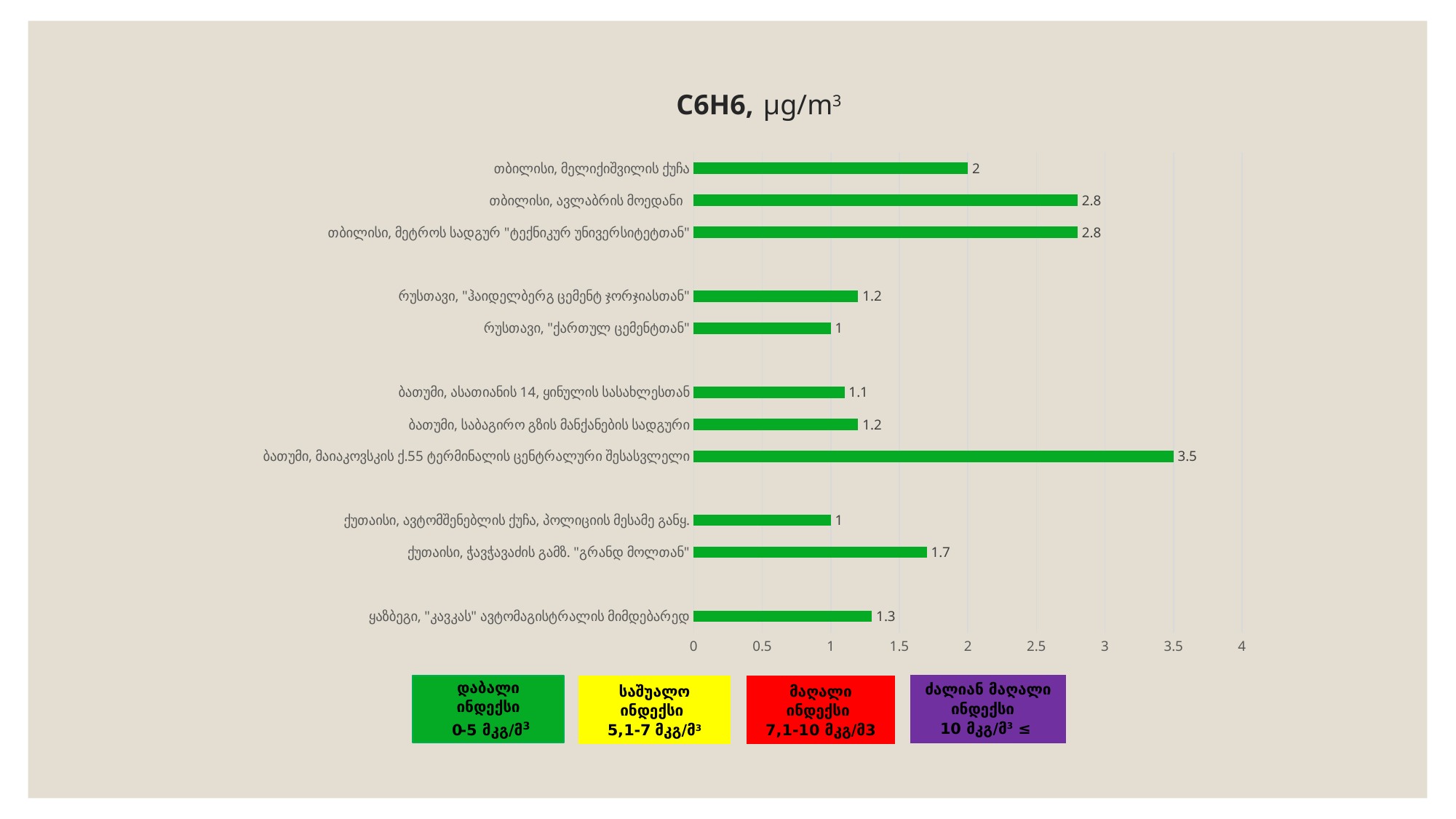
Which has a larger C6H6 value: ქუთაისი, ჭავჭავაძის გამზ. "გრანდ მოლთან" or ყაზბეგი, "კავკას" ავტომაგისტრალის მიმდებარედ? ქუთაისი, ჭავჭავაძის გამზ. "გრანდ მოლთან" What is the C6H6 value for თბილისი, მელიქიშვილის ქუჩა? 2 What is the C6H6 value for ყაზბეგი, "კავკას" ავტომაგისტრალის მიმდებარედ? 1.3 What is the C6H6 value for ბათუმი, მაიაკოვსკის ქ.55 ტერმინალის ცენტრალური შესასვლელი? 3.5 Is the value for ბათუმი, მაიაკოვსკის ქ.55 ტერმინალის ცენტრალური შესასვლელი greater or less than 3? greater What is the title of the chart? C6H6, µg/m³ What is the difference between the C6H6 values for თბილისი, ავლაბრის მოედანი and თბილისი, მელიქიშვილის ქუჩა? 0.8 What is the difference between the C6H6 values for ბათუმი, მაიაკოვსკის ქ.55 ტერმინალის ცენტრალური შესასვლელი and ქუთაისი, ჭავჭავაძის გამზ. "გრანდ მოლთან"? 1.8 What type of chart is shown on the slide? bar chart How many categories (monitoring locations) are plotted in the chart? 11 Which location has the highest C6H6 value? ბათუმი, მაიაკოვსკის ქ.55 ტერმინალის ცენტრალური შესასვლელი What is the C6H6 value for რუსთავი, "ქართულ ცემენტთან"? 1